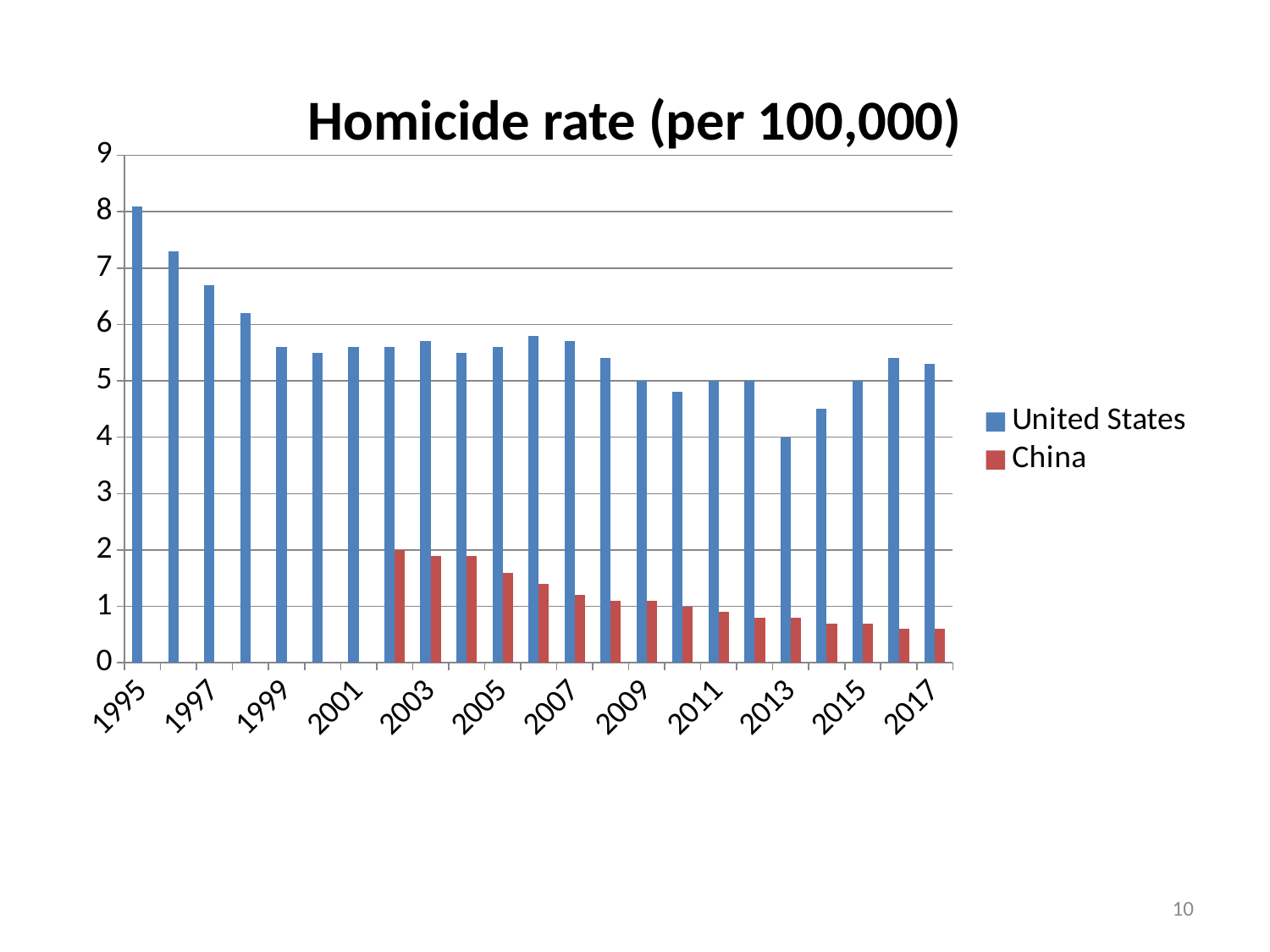
Is the China value for 2017 greater or less than 1? less What is the title of the chart? Homicide rate (per 100,000) What kind of chart is shown on the slide? bar chart How many series does the legend list? 2 Which is larger in 2009, the United States value or the China value? United States Does the China homicide rate generally rise or fall from 2003 to 2017? fall How many years are shown on the x axis, from 1995 to 2017? 23 Is the United States value for 2010 greater or less than 5? less Which two series are shown in the legend? United States and China Is the United States value for 1995 greater or less than 7? greater In which year is the United States homicide rate lowest? 2013 In which year is the United States homicide rate highest? 1995